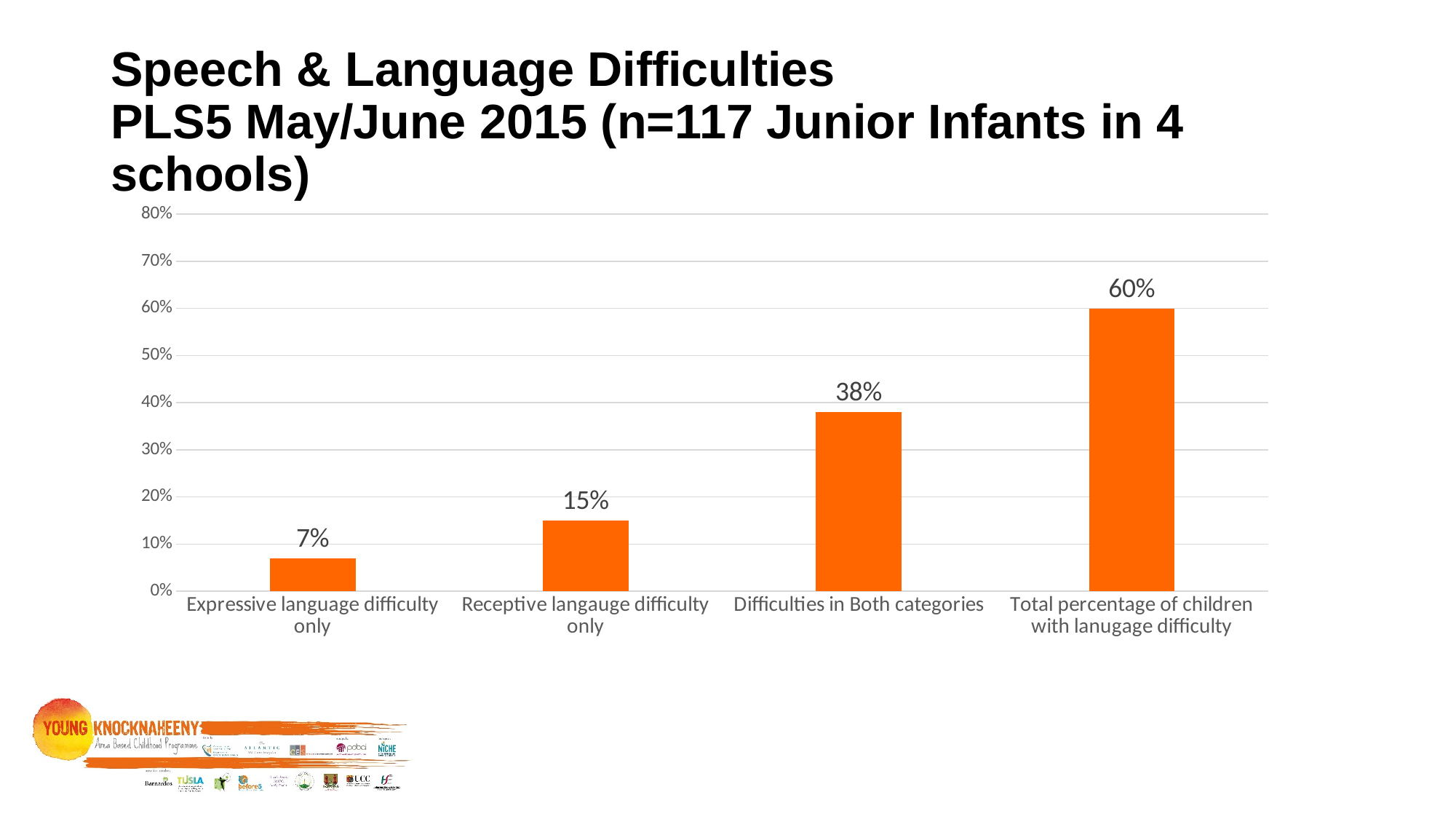
What is the value for Total percentage of children with lanugage difficulty? 60% What is the value for Expressive language difficulty only? 7% Which category has the lowest value? Expressive language difficulty only Is the value for Difficulties in Both categories greater or less than 40%? less How many categories are shown on the chart? 4 What is the value for Difficulties in Both categories? 38% What kind of chart is shown on the slide? Bar chart What is the difference between Difficulties in Both categories and Receptive langauge difficulty only? 23% Do the values rise or fall from left to right along the x axis? Rise Which category has the highest value? Total percentage of children with lanugage difficulty What is the value for Receptive langauge difficulty only? 15% Which is larger: Receptive langauge difficulty only or Expressive language difficulty only? Receptive langauge difficulty only